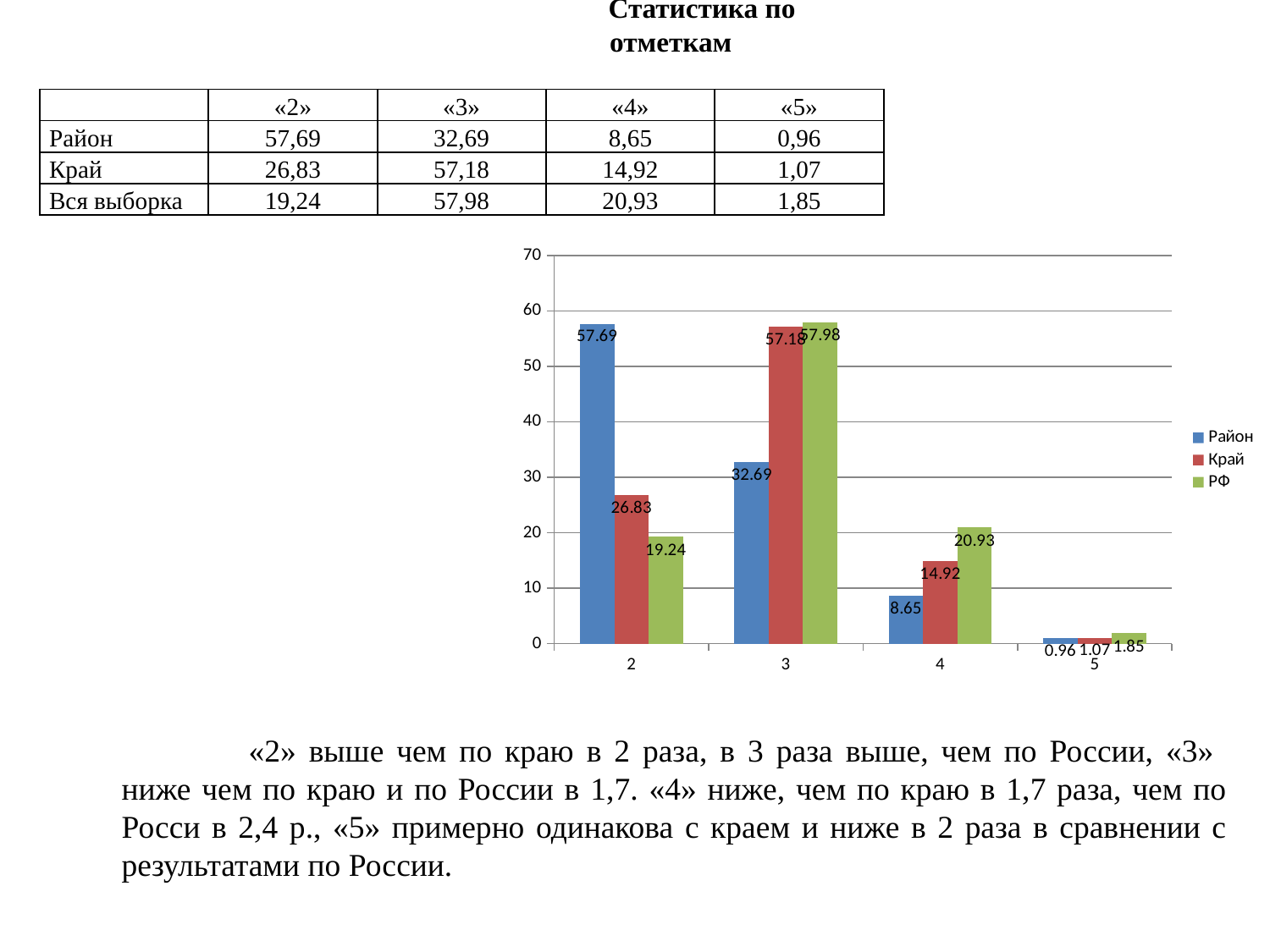
What is the value for Край at category 5? 1.07 How many categories are shown on the x axis? 4 Which is larger at category 4: the value for Край or the value for РФ? РФ What is the value for РФ at category 4? 20.93 Which category has the highest value for the Район series? 2 What is the value for Район at category 2? 57.69 What is the difference between the Район and Край values at category 2? 30.86 Which colour represents the Край series in the chart? red Is the value for Район at category 3 greater or less than 30? greater What kind of chart is shown on the slide? bar chart Which category has the lowest value for the РФ series? 5 How many series does the legend list? 3